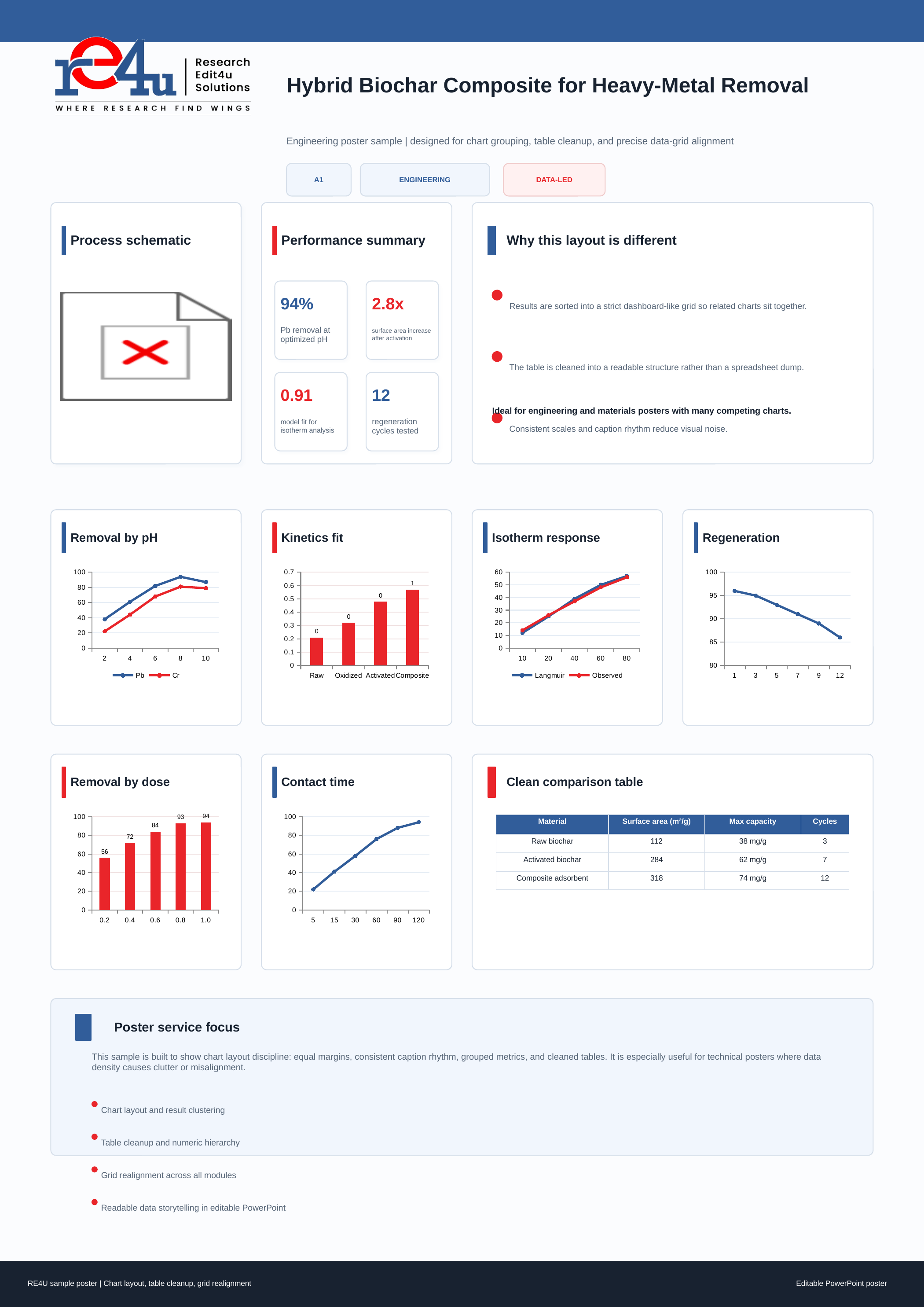
What kind of chart is the Kinetics fit chart? bar chart How many bars are plotted in the Removal by dose chart? 5 How many series does the legend of the Removal by pH chart list? 2 In the Kinetics fit chart, is the value for Raw greater or less than 0.3? less In the Removal by pH chart, which series has the larger value at pH 4, Pb or Cr? Pb In the Removal by dose chart, which dose has the highest value? 1.0 In the Kinetics fit chart, which category has the highest bar? Composite In the Regeneration chart, do the values rise or fall as the cycle number increases? fall Which two series are listed in the legend of the Isotherm response chart? Langmuir and Observed In the Removal by dose chart, what is the value for dose 0.6? 84 In the Removal by dose chart, what is the difference between the values for dose 0.4 and dose 0.2? 16 In the Removal by dose chart, which dose has the lowest value? 0.2